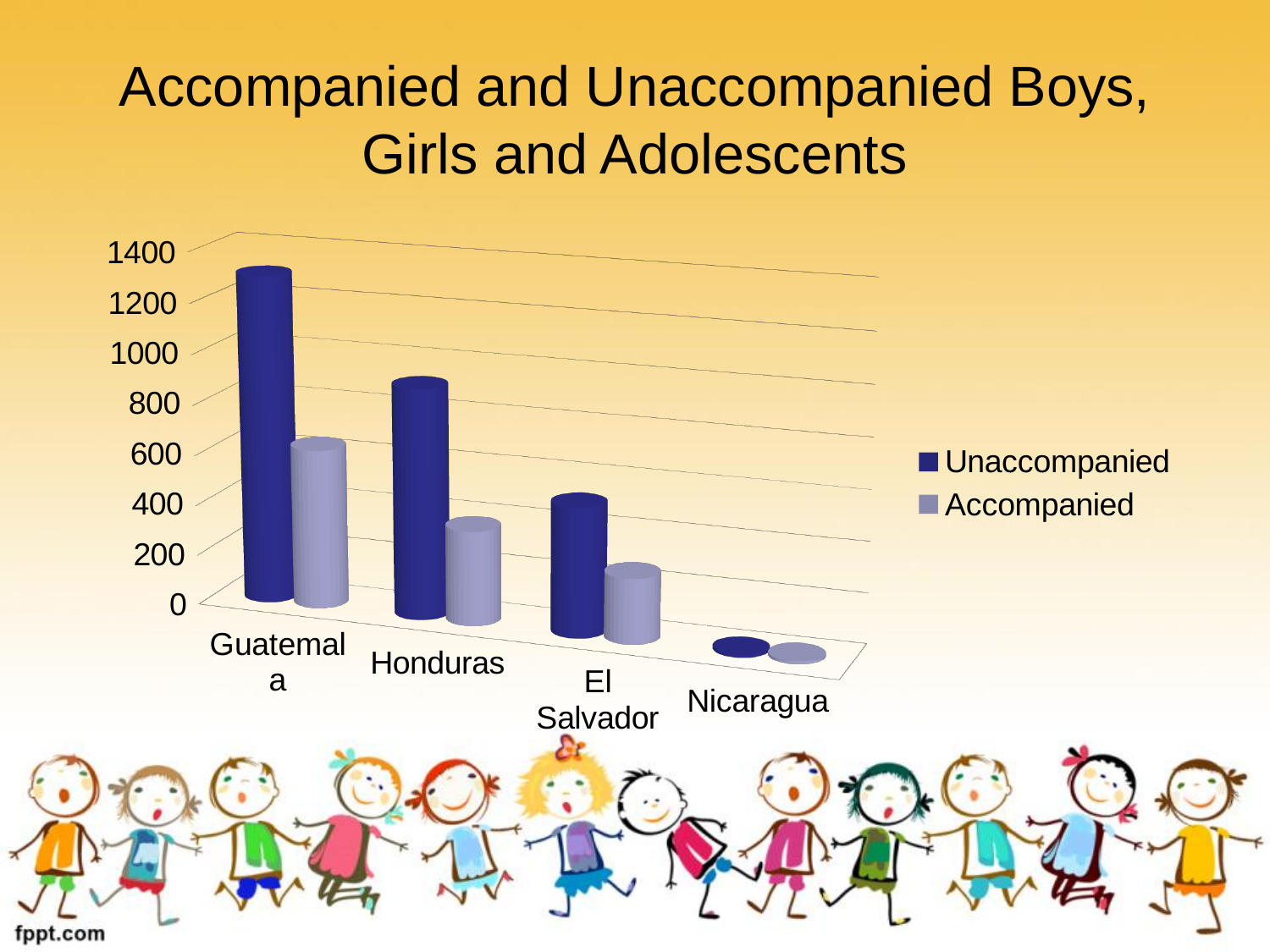
Is the Unaccompanied value for Guatemala greater or less than 1200? greater Do the Unaccompanied values rise or fall moving from Guatemala to Nicaragua along the x axis? fall Is the Accompanied value for Honduras greater or less than 400? less Which country has the highest Unaccompanied value? Guatemala What kind of chart is shown on the slide? bar chart How many countries are shown on the x axis of the chart? 4 Is the Accompanied value for El Salvador greater or less than 200? greater For Guatemala, which is larger: the Unaccompanied value or the Accompanied value? Unaccompanied Which country has the lowest Accompanied value? Nicaragua What is the title of the chart on the slide? Accompanied and Unaccompanied Boys, Girls and Adolescents How many series does the chart's legend list? 2